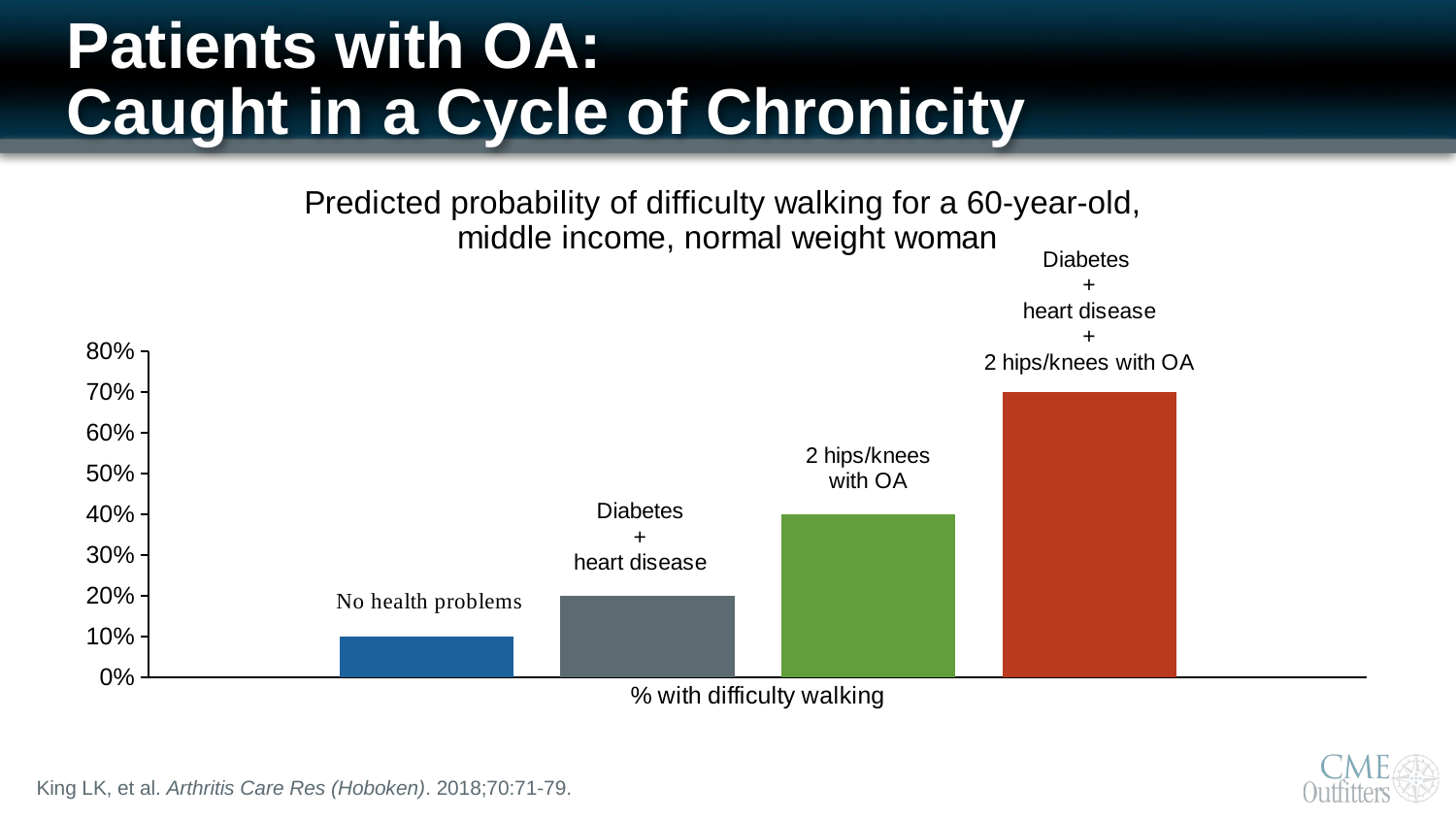
What is the value for Diabetes + heart disease + 2 hips/knees with OA? 70% What is the value for Diabetes + heart disease? 20% What is the value for No health problems? 10% How many categories are shown in the chart? 4 Which category has the highest value? Diabetes + heart disease + 2 hips/knees with OA Which is larger, the value for 2 hips/knees with OA or the value for Diabetes + heart disease? 2 hips/knees with OA What is the value for 2 hips/knees with OA? 40% What is the difference between the highest and lowest values? 60% Which category has the lowest value? No health problems What is the label on the x axis of the chart? % with difficulty walking What kind of chart is shown? Bar chart What is the difference between the values for 2 hips/knees with OA and Diabetes + heart disease? 20%